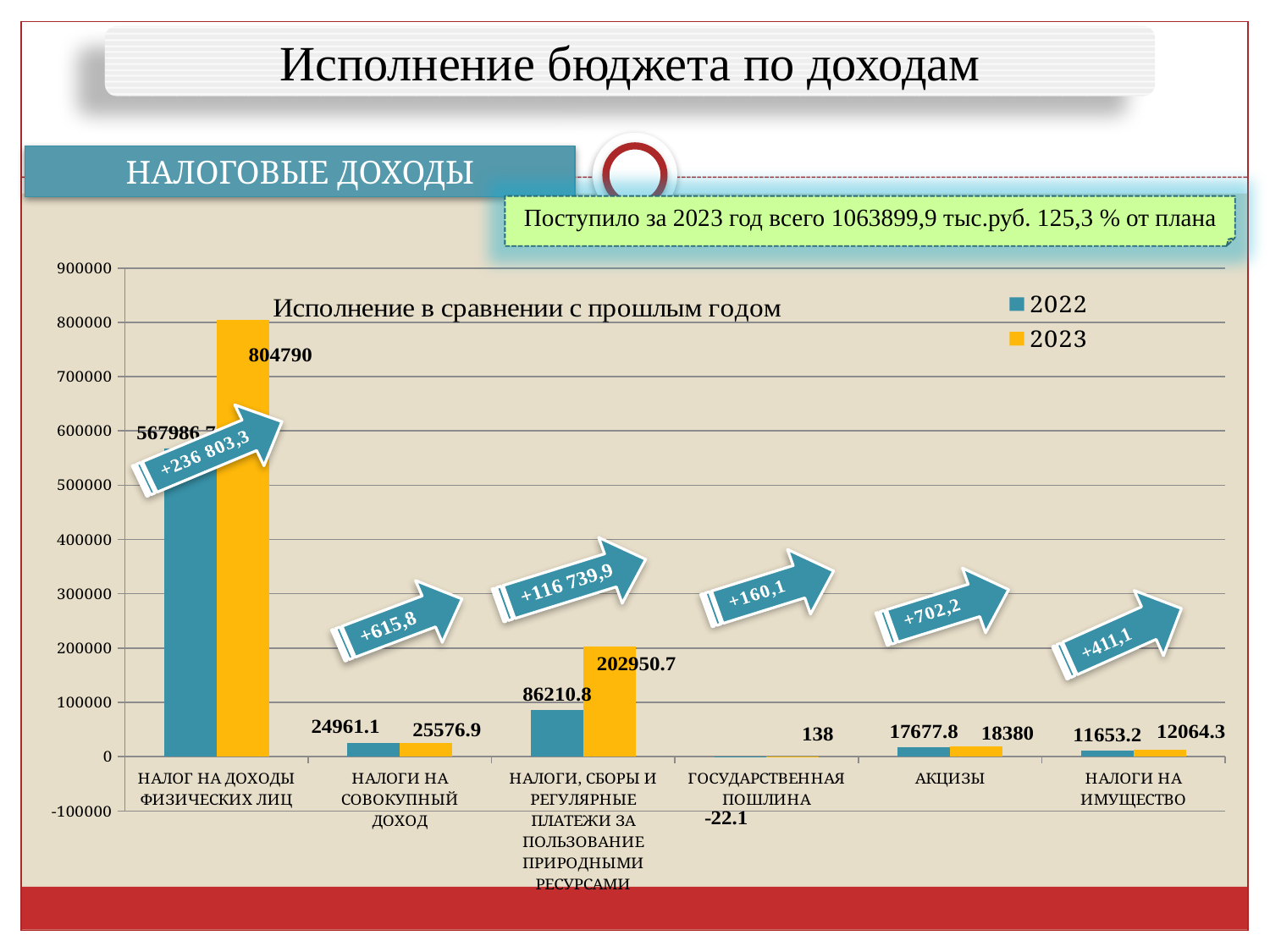
What is the difference between the 2023 and 2022 values for НАЛОГИ НА ИМУЩЕСТВО? 411.1 What is the 2022 value for ГОСУДАРСТВЕННАЯ ПОШЛИНА? -22.1 Is the 2022 value for НАЛОГ НА ДОХОДЫ ФИЗИЧЕСКИХ ЛИЦ greater or less than 500000? greater Which category has the lowest 2022 value? ГОСУДАРСТВЕННАЯ ПОШЛИНА What kind of chart is shown on the slide? bar chart Which is larger for НАЛОГИ НА СОВОКУПНЫЙ ДОХОД, the 2022 value or the 2023 value? 2023 What is the 2023 value for НАЛОГ НА ДОХОДЫ ФИЗИЧЕСКИХ ЛИЦ? 804790 How many series does the chart legend list? 2 What is the 2022 value for АКЦИЗЫ? 17677.8 How many categories are shown on the x axis of the chart? 6 Which category has the highest 2023 value? НАЛОГ НА ДОХОДЫ ФИЗИЧЕСКИХ ЛИЦ What is the 2023 value for НАЛОГИ, СБОРЫ И РЕГУЛЯРНЫЕ ПЛАТЕЖИ ЗА ПОЛЬЗОВАНИЕ ПРИРОДНЫМИ РЕСУРСАМИ? 202950.7